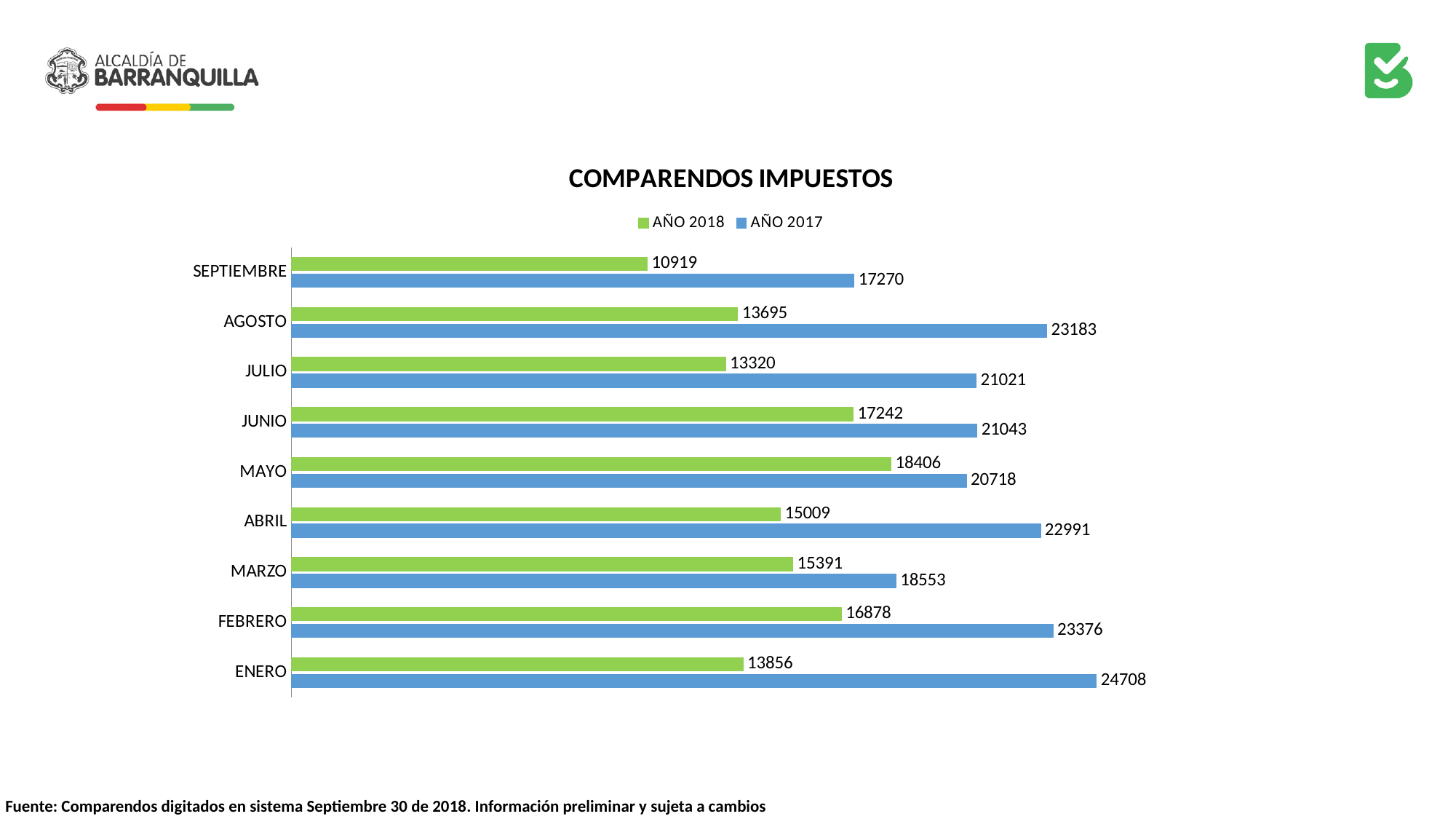
What is the value for AÑO 2017 in ENERO? 24708 What is the difference between AÑO 2017 and AÑO 2018 in AGOSTO? 9488 Which is larger in FEBRERO, AÑO 2018 or AÑO 2017? AÑO 2017 What is the difference between AÑO 2017 and AÑO 2018 in ENERO? 10852 What is the value for AÑO 2018 in MAYO? 18406 What is the value for AÑO 2018 in SEPTIEMBRE? 10919 Which month has the highest value for AÑO 2018? MAYO What kind of chart is shown on the slide? Bar chart Which month has the lowest value for AÑO 2018? SEPTIEMBRE How many months are shown on the chart? 9 Which month has the highest value for AÑO 2017? ENERO How many series does the legend list? 2